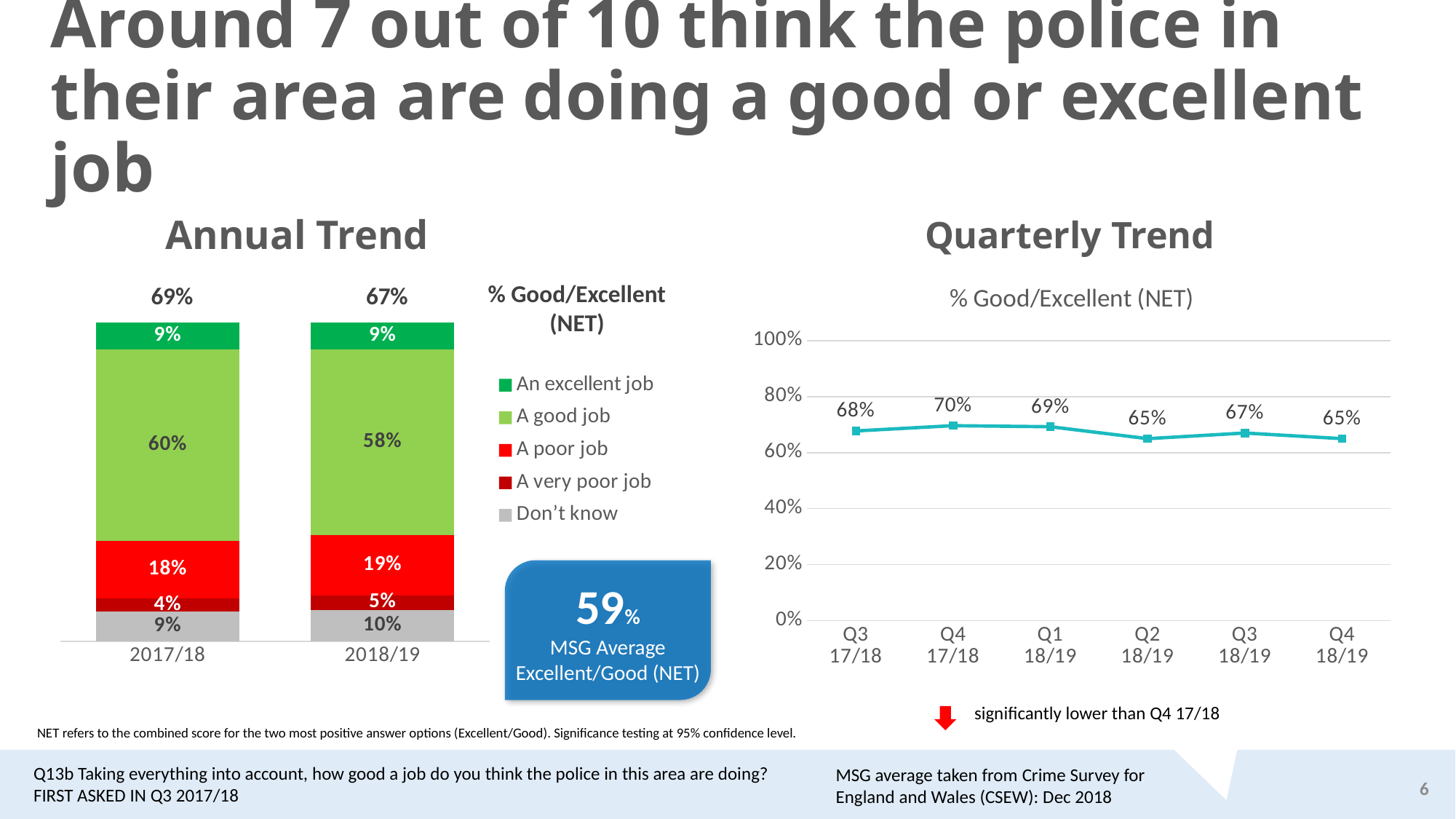
What kind of chart is the Quarterly Trend chart? Line chart In the Quarterly Trend chart, how many quarters are plotted? 6 In the Annual Trend chart, which year has the larger 'A very poor job' share, 2017/18 or 2018/19? 2018/19 In the Annual Trend chart, what is the % Good/Excellent (NET) figure for 2017/18? 69% What kind of chart is the Annual Trend chart? Stacked bar chart In the Quarterly Trend chart, what is the difference between the Q4 17/18 and Q4 18/19 values? 5% In the Quarterly Trend chart, which quarter has the highest % Good/Excellent (NET)? Q4 17/18 In the Annual Trend chart, what is the difference between the 'A poor job' values for 2018/19 and 2017/18? 1% In the Annual Trend chart, what percentage said the police are doing a good job in 2018/19? 58% In the Annual Trend chart, what percentage answered 'Don't know' in 2017/18? 9% In the Annual Trend chart, how many series does the legend list? 5 In the Quarterly Trend chart, what is the % Good/Excellent (NET) value for Q4 17/18? 70%